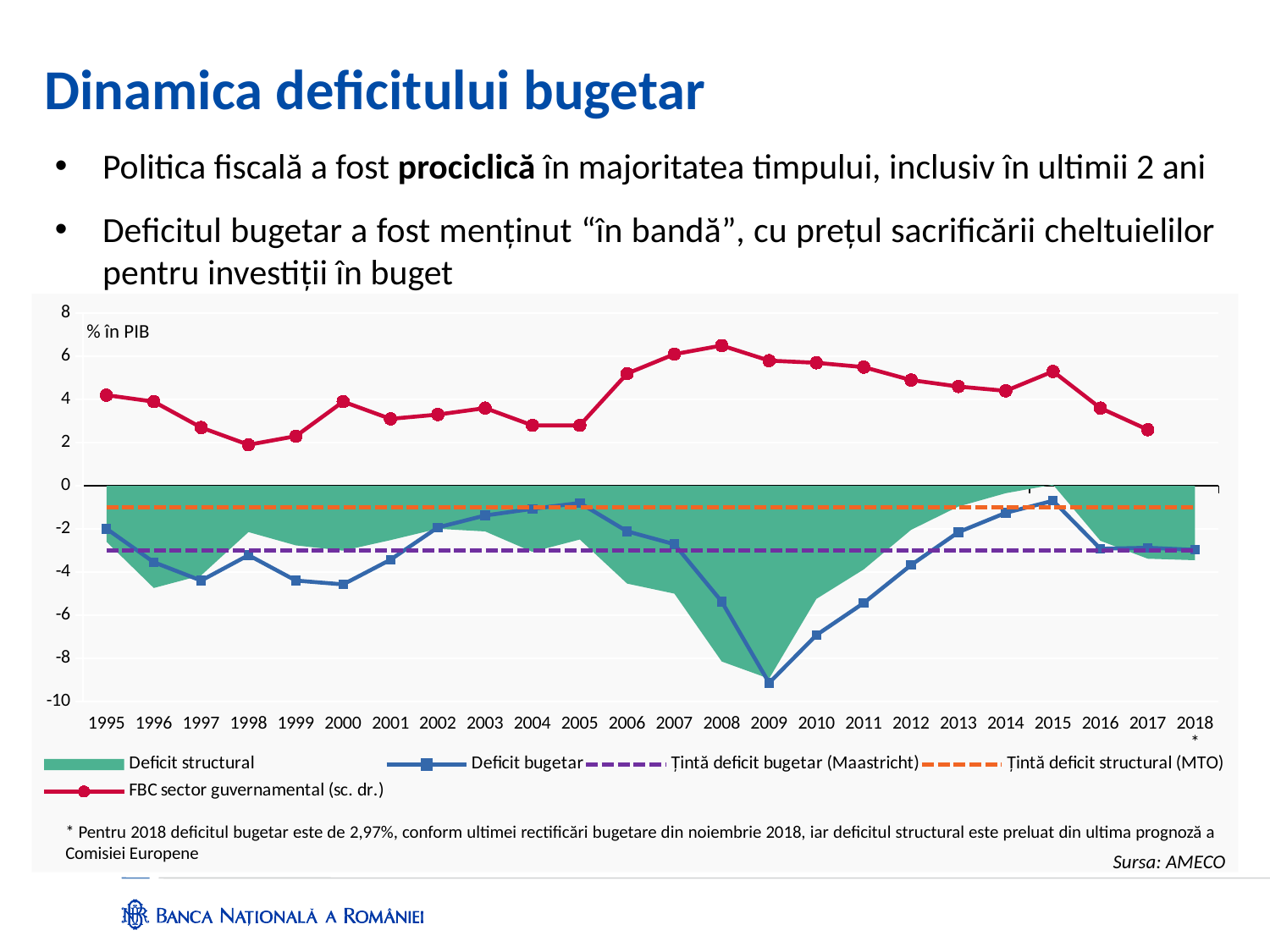
What unit label is shown at the top of the chart's y axis? % în PIB Is the value of Deficit bugetar in 2000 greater or less than -4? less How many series does the chart legend list? 5 Is the value of FBC sector guvernamental (sc. dr.) in 2008 greater or less than 6? greater What kind of chart is shown on the slide? combination area and line chart How many years are shown on the x axis of the chart? 24 In which year is the Deficit bugetar series at its lowest value? 2009 In which year is the FBC sector guvernamental (sc. dr.) series at its lowest value? 1998 In which year does the FBC sector guvernamental (sc. dr.) series reach its highest value? 2008 Is the value of Deficit bugetar in 2009 greater or less than -8? less Does the Deficit bugetar series rise or fall between 2009 and 2015? rise